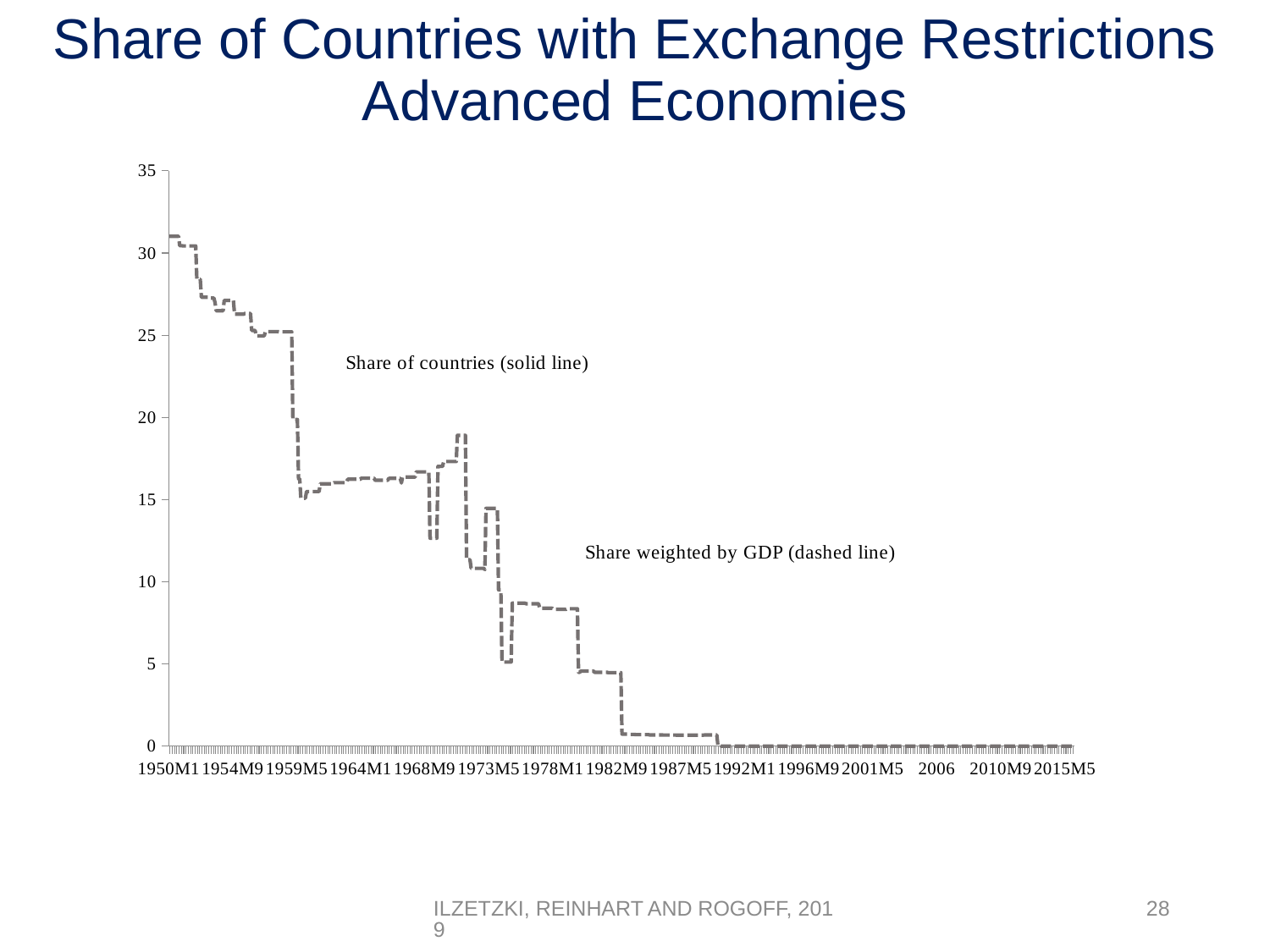
Is the value of the dashed line at 1954M9 greater or less than 25? greater Overall, does the dashed line rise or fall from 1950M1 to 2015M5? fall What is the title of the slide's chart? Share of Countries with Exchange Restrictions Advanced Economies Is the value of the dashed line at 1964M1 greater or less than 15? greater Is the value of the dashed line at 1964M1 greater or less than 20? less What is the highest value shown on the vertical axis? 35 What kind of chart is shown on the slide? line chart Which is larger, the dashed line's value at 1950M1 or its value at 1992M1? 1950M1